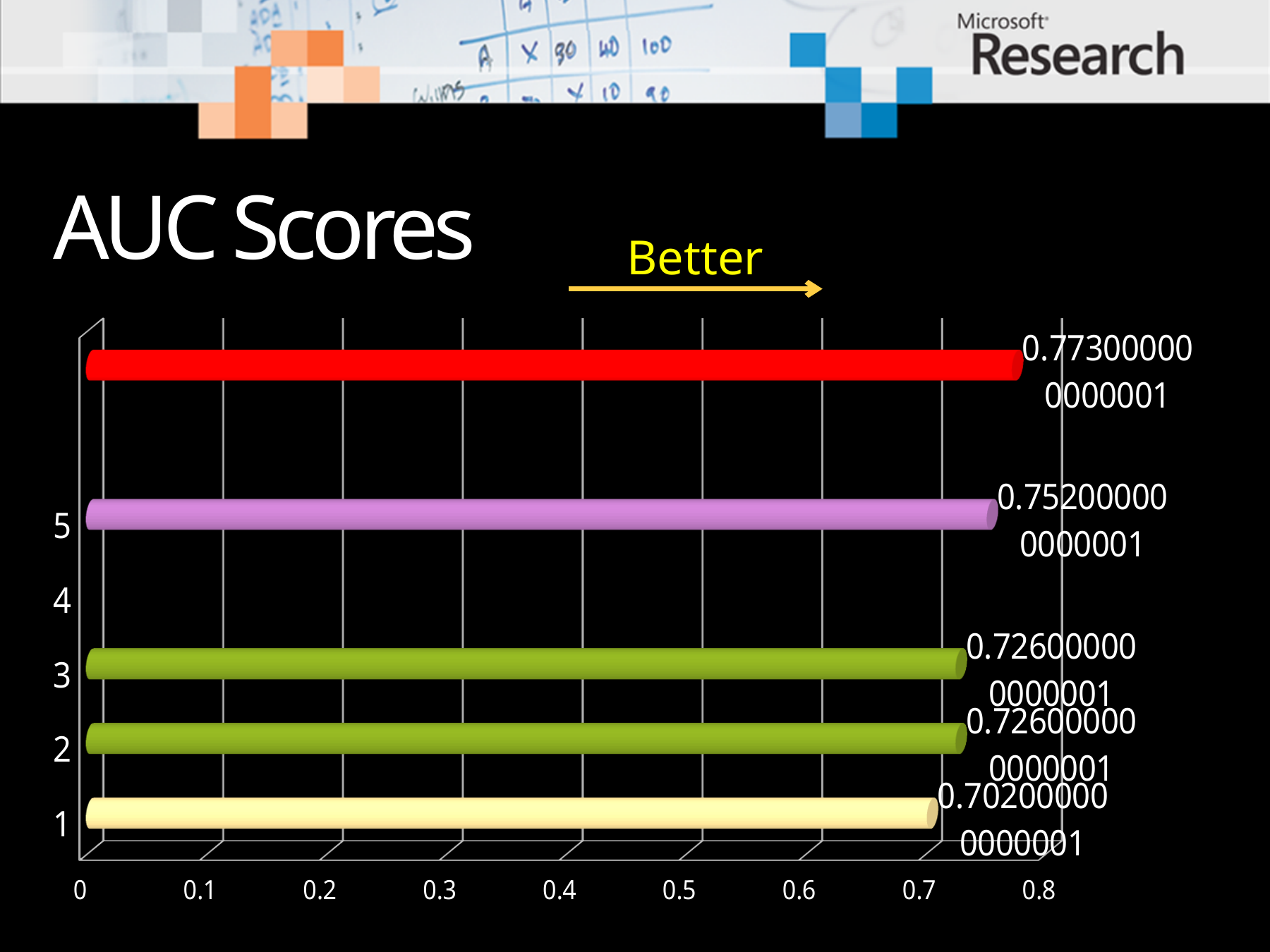
Is the AUC score for category 3 greater or less than 0.8? less What kind of chart is shown on the slide? bar chart What is the data label shown for category 1? 0.702000000000001 Is the AUC score for category 2 greater or less than 0.6? greater How many bars are plotted in the chart? 5 Which has a higher AUC score, category 5 or category 3? category 5 What is the title of the chart? AUC Scores What word is written above the arrow pointing to the right? Better Which category has the lowest AUC score? 1 Is the AUC score for category 5 greater or less than 0.7? greater What is the data label shown for category 5? 0.752000000000001 Which bar has the highest AUC score? the red bar at the top